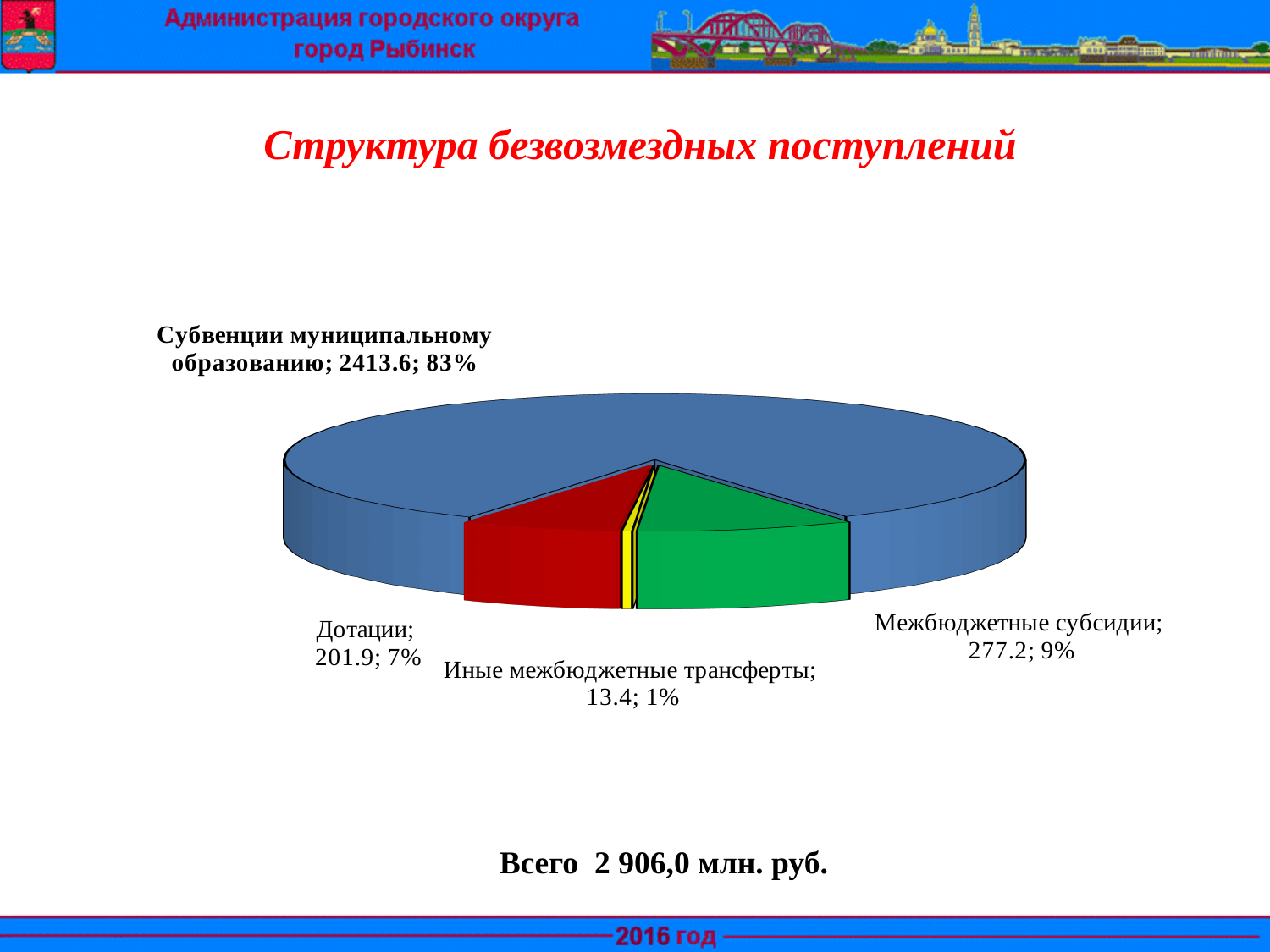
What is the value for Иные межбюджетные трансферты? 13.4 Which category has the largest slice? Субвенции муниципальному образованию What is the difference between the values for Межбюджетные субсидии and Дотации? 75.3 What share of the pie does Дотации take? 7% Which is larger, Межбюджетные субсидии or Дотации? Межбюджетные субсидии What kind of chart is shown on the slide? pie chart What is the value for Субвенции муниципальному образованию? 2413.6 What is the value for Межбюджетные субсидии? 277.2 Which category has the smallest slice? Иные межбюджетные трансферты What is the value for Дотации? 201.9 How many slices does the pie chart have? 4 What share of the pie does Субвенции муниципальному образованию take? 83%